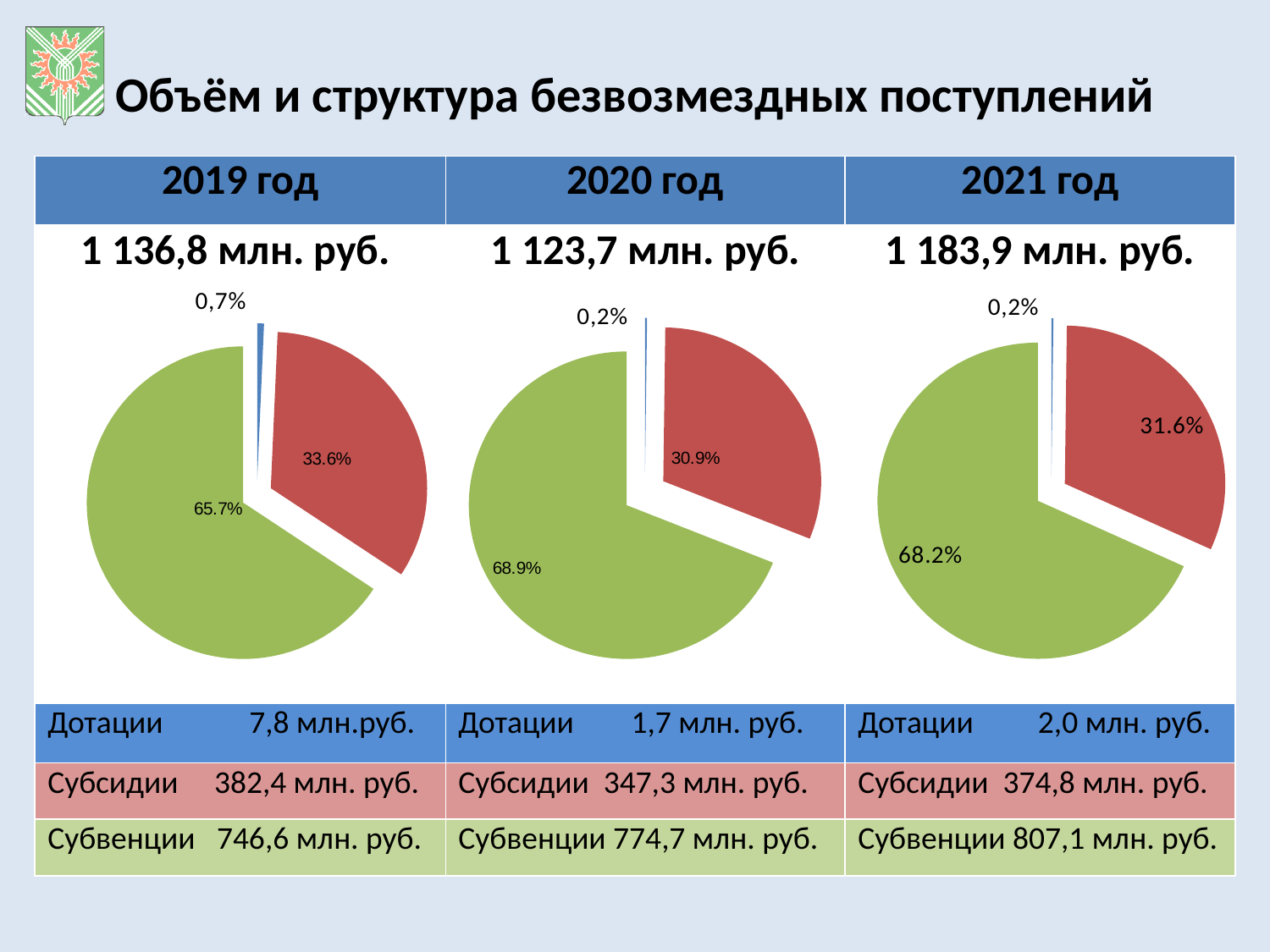
How many pie charts are shown on the slide? 3 In the 2021 год pie chart, which slice is the largest? Субвенции (green, 68.2%) What type of chart is used for each year on the slide? Pie chart In the 2020 год pie chart, what share is shown for the red slice (Субсидии)? 30.9% In the 2021 год pie chart, what share is shown for the red slice (Субсидии)? 31.6% In the 2020 год pie chart, what share is shown for the green slice (Субвенции)? 68.9% Which is larger: the red slice in the 2019 год pie chart or the red slice in the 2021 год pie chart? 2019 год (33.6%) In the 2020 год pie chart, which slice is the smallest? Дотации (blue, 0,2%)